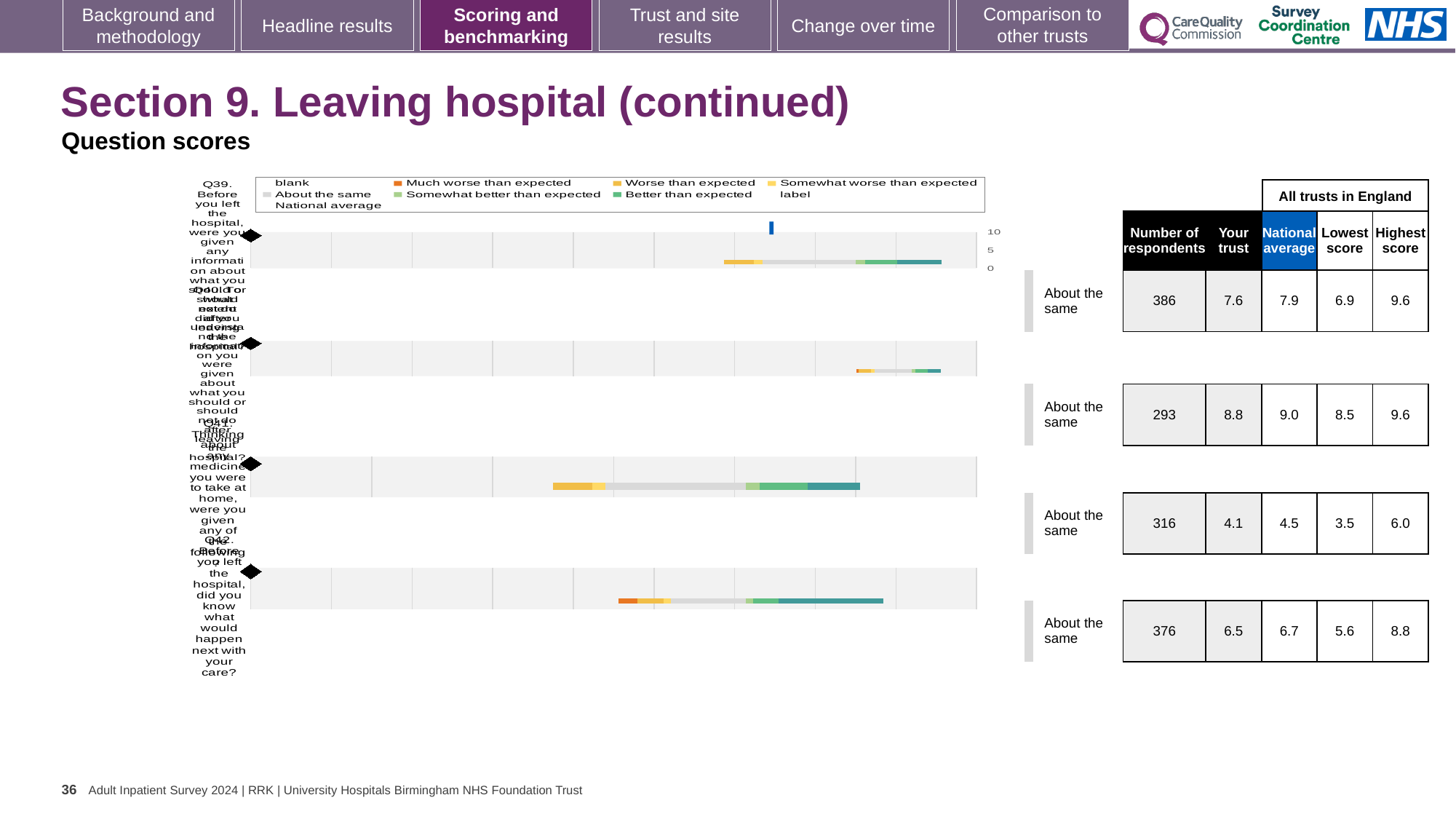
What is the lowest score in England for the fourth row (Q42)? 5.6 What is the difference between the national average and the 'Your trust' score for the third row (Q41)? 0.4 What benchmark label is shown next to each of the four bars? About the same Which row has the lowest 'Your trust' score? Q41 (third row), 4.1 Which row has the highest number of respondents? Q39 (first row), 386 What kind of chart is shown on the slide? bar chart What is the national average for the second row (Q40)? 9.0 What is the number of respondents for the first row (Q39) in the table beside the chart? 386 How many question rows (bars) does the chart show? 4 What is the 'Your trust' score for the first row (Q39)? 7.6 Which has the higher 'Your trust' score, the first row (Q39) or the second row (Q40)? Q40 (second row) What is the highest score in England for the third row (Q41)? 6.0